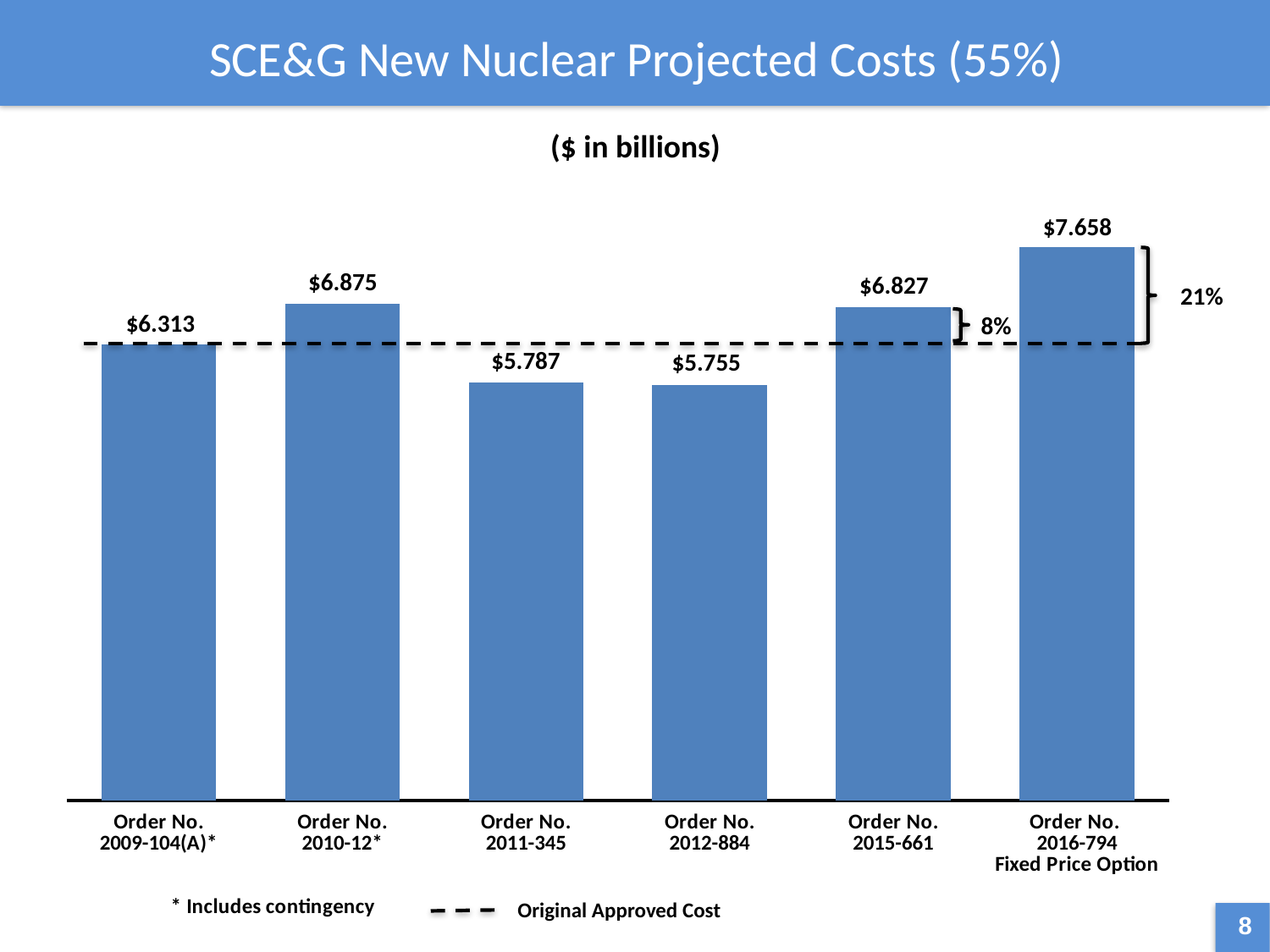
What is the difference between the projected costs for Order No. 2010-12* and Order No. 2009-104(A)*? $0.562 What is the difference between the projected costs for Order No. 2016-794 Fixed Price Option and Order No. 2015-661? $0.831 What is the projected cost for Order No. 2011-345? $5.787 What is the projected cost for Order No. 2016-794 Fixed Price Option? $7.658 Which is larger, the projected cost for Order No. 2010-12* or for Order No. 2015-661? Order No. 2010-12* What kind of chart is shown on the slide? Bar chart How many orders are shown on the chart? 6 Which order has the highest projected cost? Order No. 2016-794 Fixed Price Option What does the dashed horizontal line on the chart represent? Original Approved Cost What percentage increase over the original approved cost is labelled for Order No. 2016-794 Fixed Price Option? 21% What is the projected cost for Order No. 2009-104(A)*? $6.313 Which order has the lowest projected cost? Order No. 2012-884